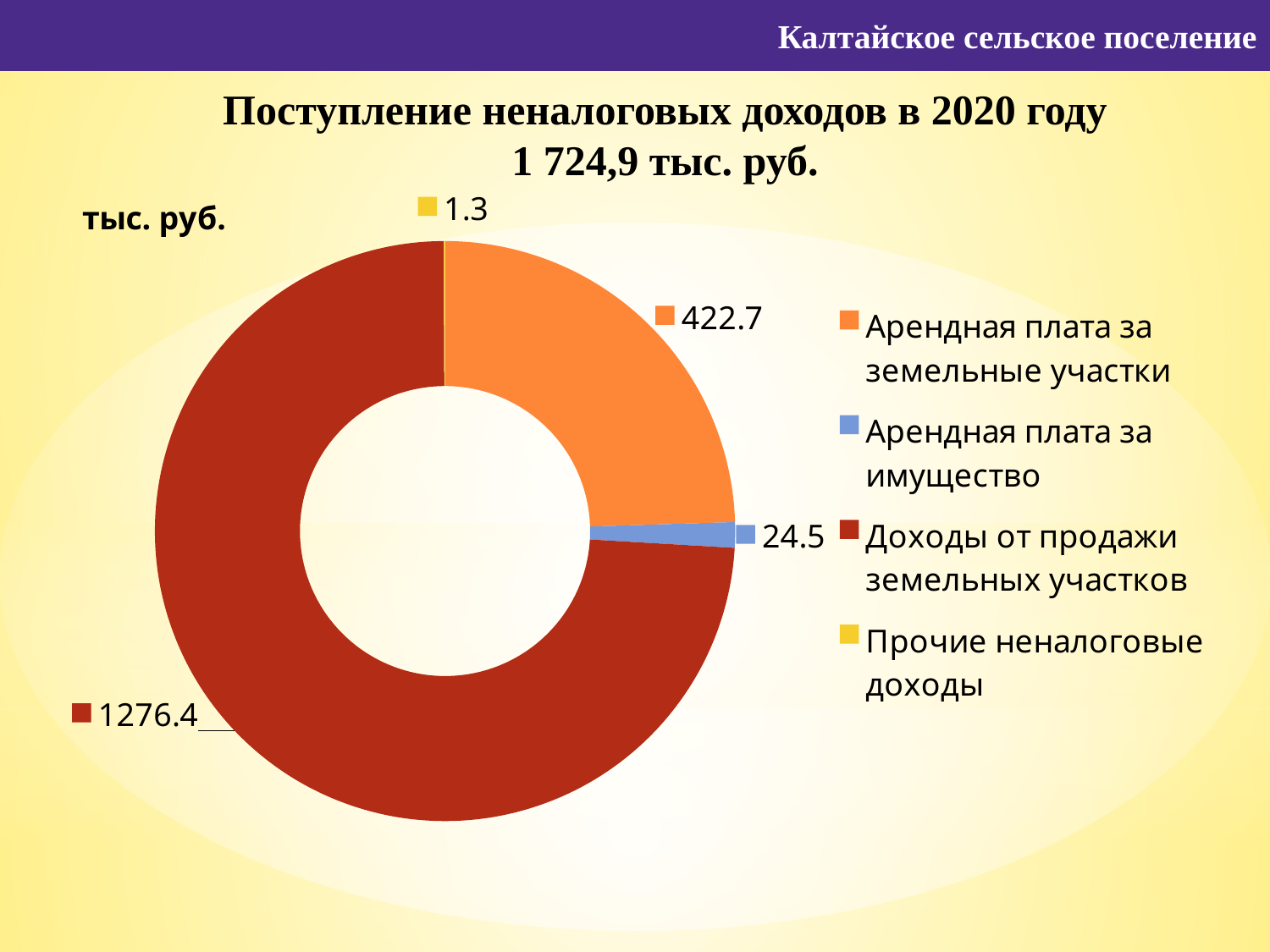
What is the difference between Доходы от продажи земельных участков and Арендная плата за земельные участки? 853.7 Which category has the highest value? Доходы от продажи земельных участков What is the value for Прочие неналоговые доходы? 1.3 Which is larger: Арендная плата за земельные участки or Арендная плата за имущество? Арендная плата за земельные участки What share of the total does Доходы от продажи земельных участков represent? 74.0% What is the title of the chart? тыс. руб. How many categories does the chart show? 4 What is the value for Арендная плата за земельные участки? 422.7 What is the value for Арендная плата за имущество? 24.5 Which category has the lowest value? Прочие неналоговые доходы What kind of chart is shown on the slide? Doughnut (pie) chart What is the value for Доходы от продажи земельных участков? 1276.4